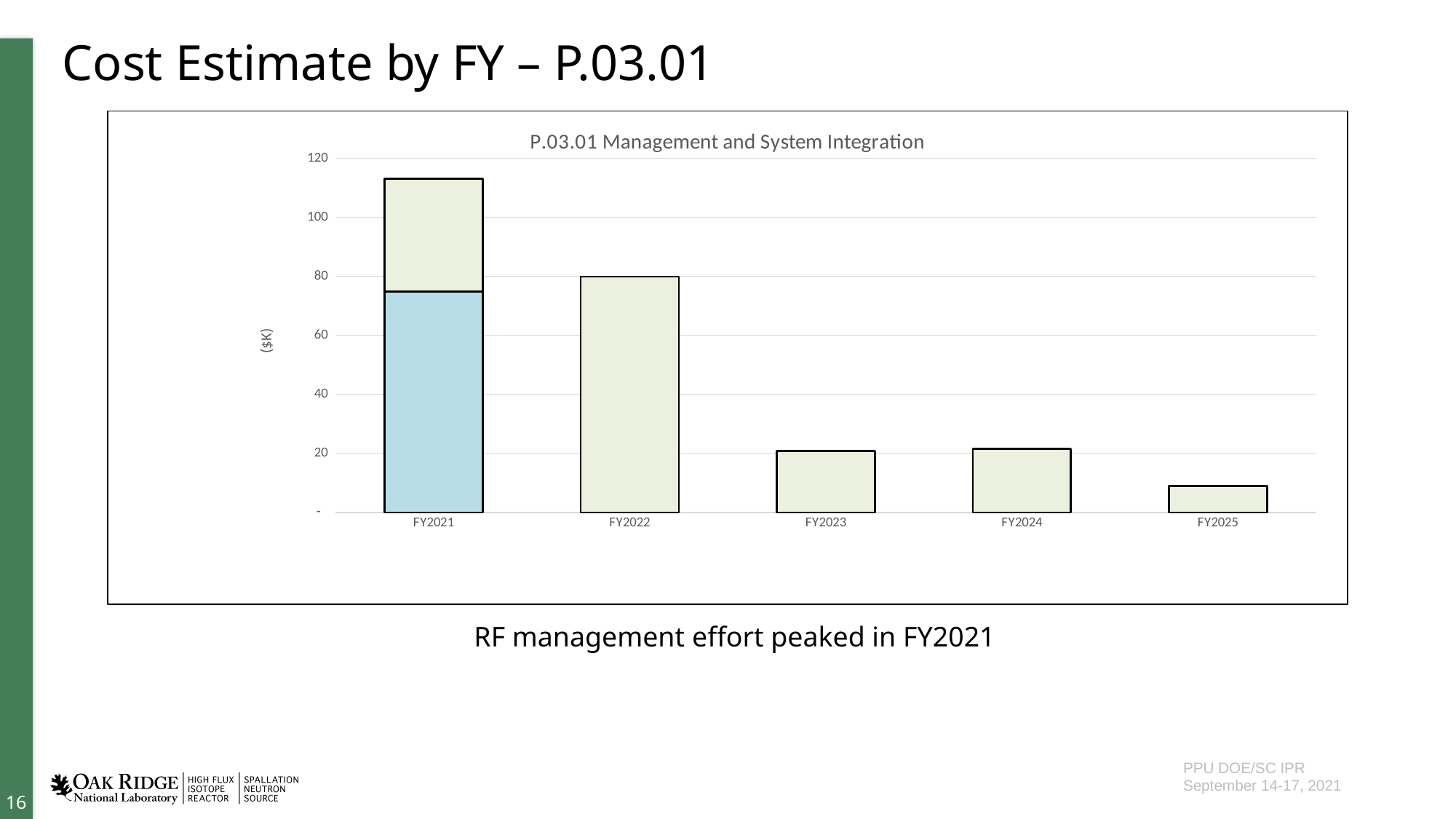
Is the value for FY2022 greater or less than 100? less What is the title of the chart? P.03.01 Management and System Integration Is the total value for FY2021 greater or less than 100? greater What is the label on the y axis of the chart? ($K) How many fiscal years are shown on the x axis of the chart? 5 Do the bar values rise or fall from FY2021 to FY2023? fall Which fiscal year has the highest bar in the chart? FY2021 Is the value for FY2023 greater or less than 40? less Which is larger, the bar for FY2022 or the bar for FY2023? FY2022 What kind of chart is shown on the slide? bar chart Which fiscal year has the lowest bar in the chart? FY2025